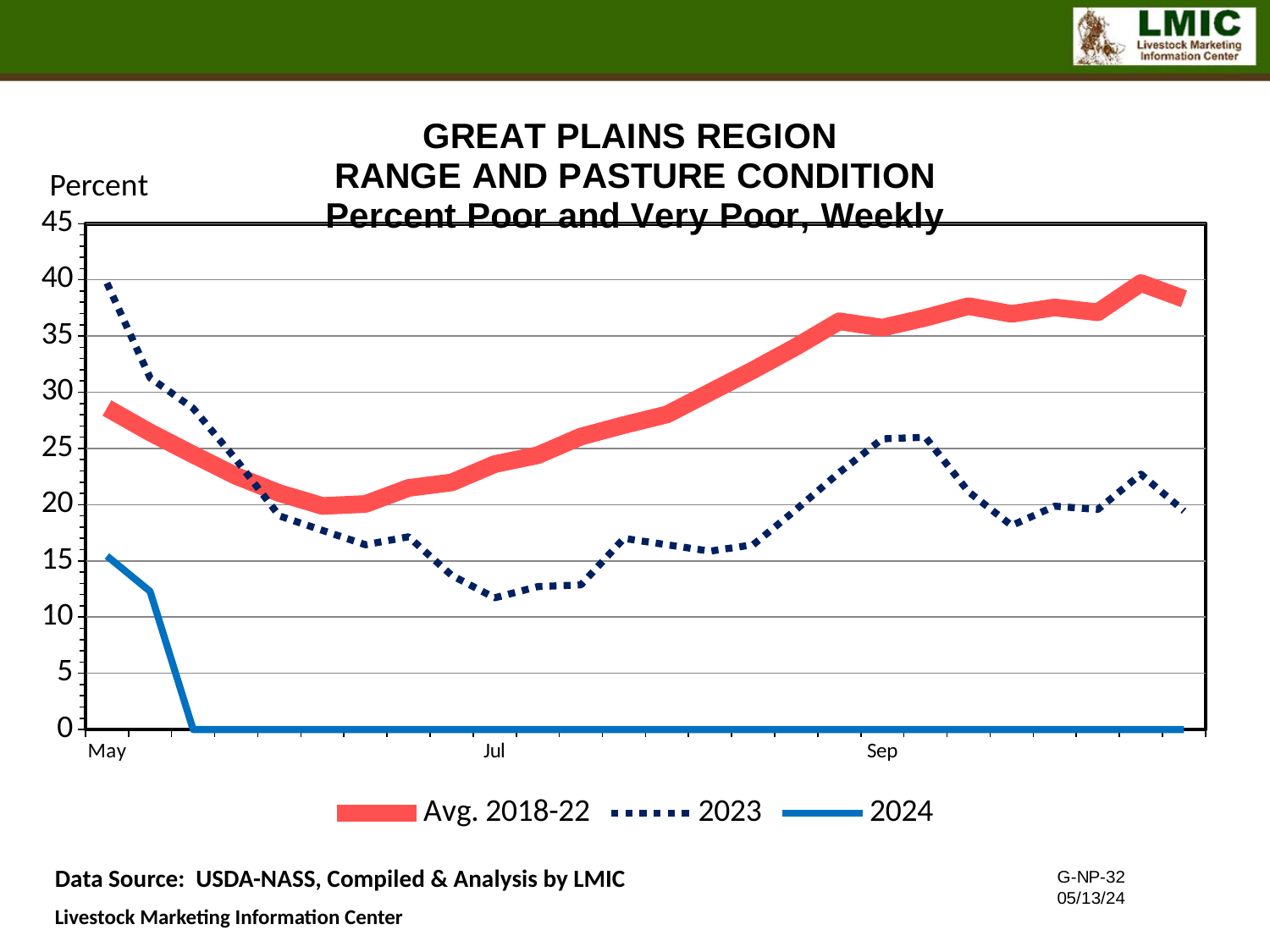
What is the label on the vertical axis? Percent At the start of May, which series has the higher value, 2023 or Avg. 2018-22? 2023 How many series does the legend list? 3 Is the value for 2023 at the start of May greater or less than 35? greater Is the value for Avg. 2018-22 at the start of May greater or less than 25? greater Does the Avg. 2018-22 line rise or fall between Jul and Sep? rise Is the value for Avg. 2018-22 at Sep greater or less than 30? greater What are the three series listed in the legend? Avg. 2018-22, 2023, 2024 What kind of chart is shown on the slide? line chart Which series has the lowest value at Sep? 2024 At Sep, which series has the higher value, Avg. 2018-22 or 2023? Avg. 2018-22